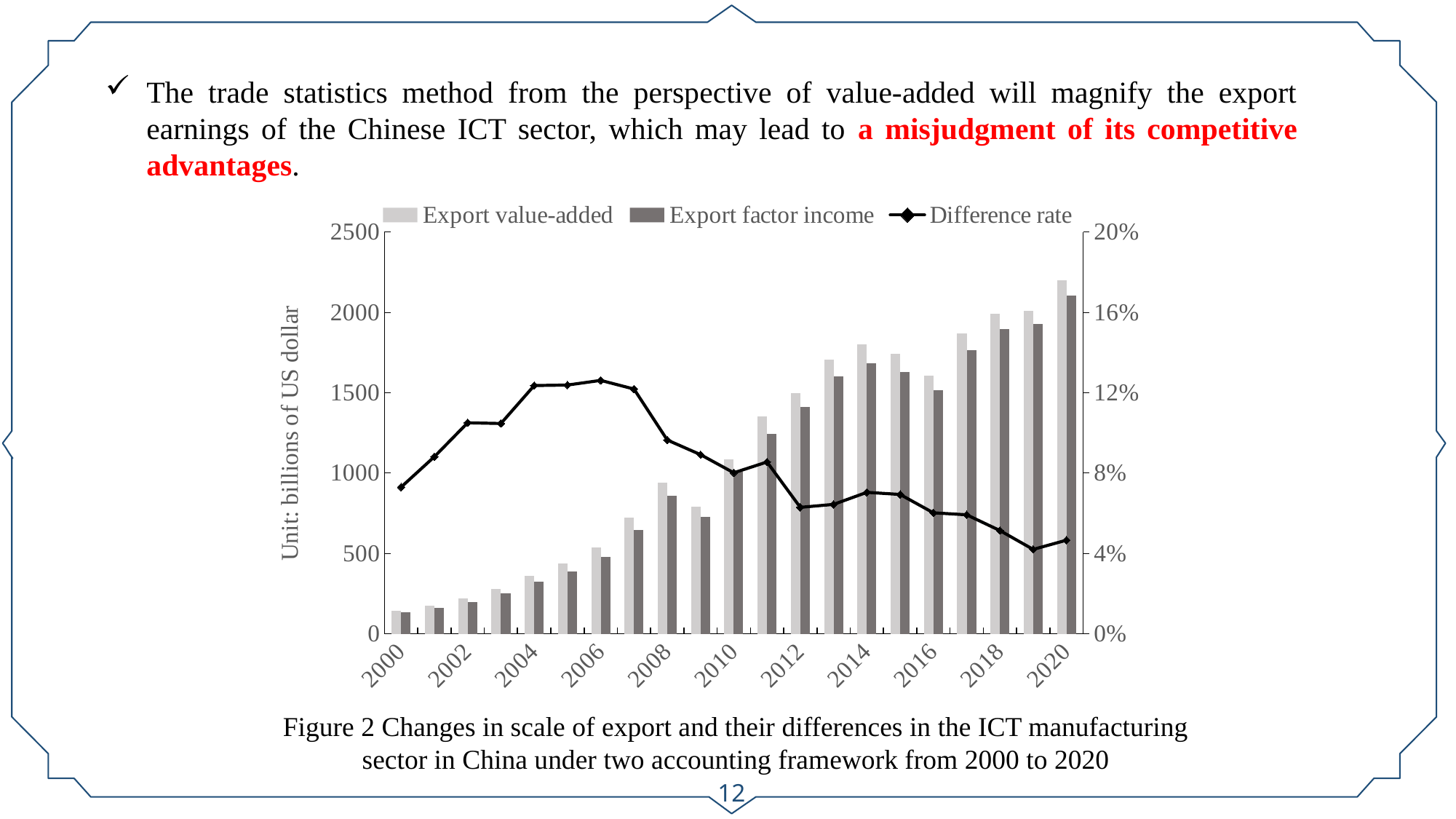
How many series does the legend list? 3 Is the value for Export value-added in 2020 greater or less than 2000? greater In which year is Export factor income lowest? 2000 In 2020, which is larger: Export value-added or Export factor income? Export value-added In which year is Export value-added highest? 2020 What unit is given on the left vertical axis label? Unit: billions of US dollar What are the three series named in the legend? Export value-added, Export factor income, Difference rate Does the Difference rate generally rise or fall from 2008 to 2020? Fall Is the Difference rate in 2000 greater or less than 8%? less Is the value for Export value-added in 2008 greater or less than 1000? less What kind of chart is shown on the slide? A combined bar and line chart Does Export factor income generally rise or fall from 2000 to 2020? Rise